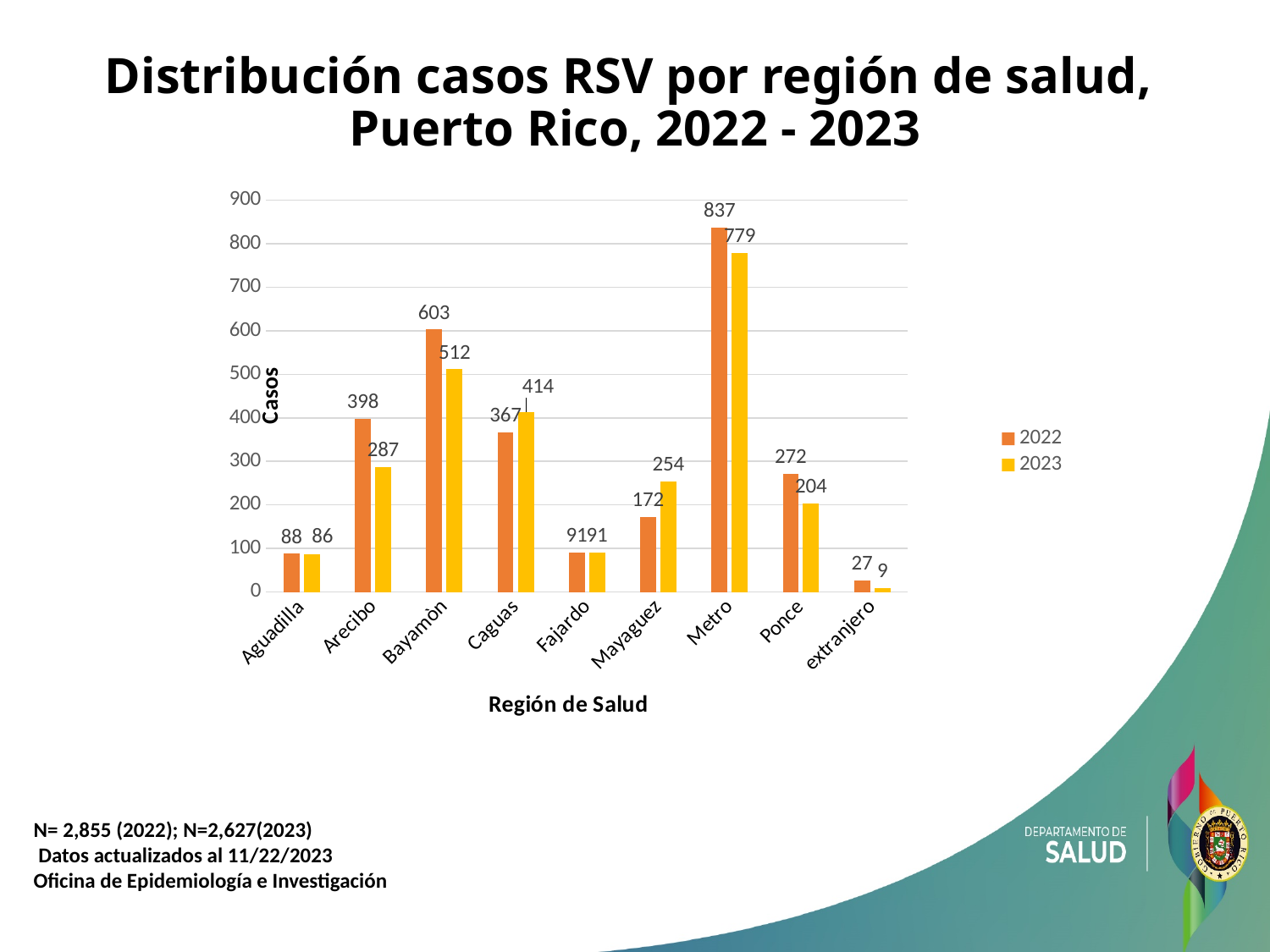
How many series does the legend list? 2 How many regions are shown on the x axis? 9 What is the value for Metro in 2022? 837 Which region has the lowest value in 2022? extranjero Which region has the highest value in 2023? Metro What is the difference between the 2022 and 2023 values for Arecibo? 111 What is the label of the y axis? Casos What kind of chart is shown on the slide? bar chart What is the value for Ponce in 2022? 272 Is the value for Mayaguez in 2023 greater or less than 200? greater Which is larger for Caguas, the 2022 value or the 2023 value? 2023 What is the value for Bayamòn in 2023? 512